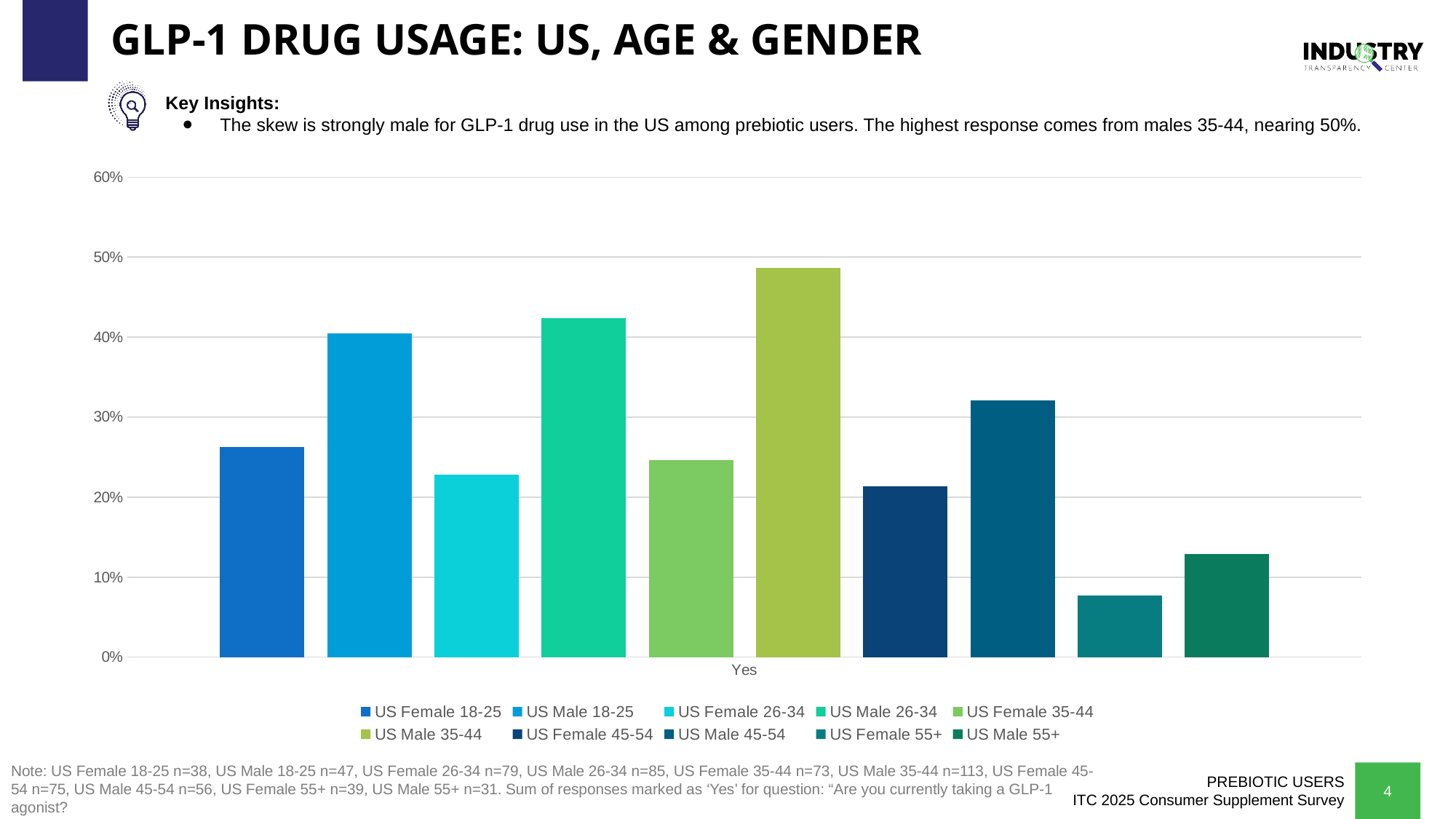
Is the value for US Female 55+ greater or less than 10%? less Is the value for US Male 26-34 greater or less than 40%? greater What is the label on the x axis under the bars? Yes Which series has the lowest value? US Female 55+ Is the value for US Male 55+ greater or less than 10%? greater Which is larger, the value for US Female 18-25 or US Female 26-34? US Female 18-25 What kind of chart is shown on the slide? bar chart Which series has the highest value? US Male 35-44 How many series does the legend list? 10 Which is larger, the value for US Male 45-54 or US Female 45-54? US Male 45-54